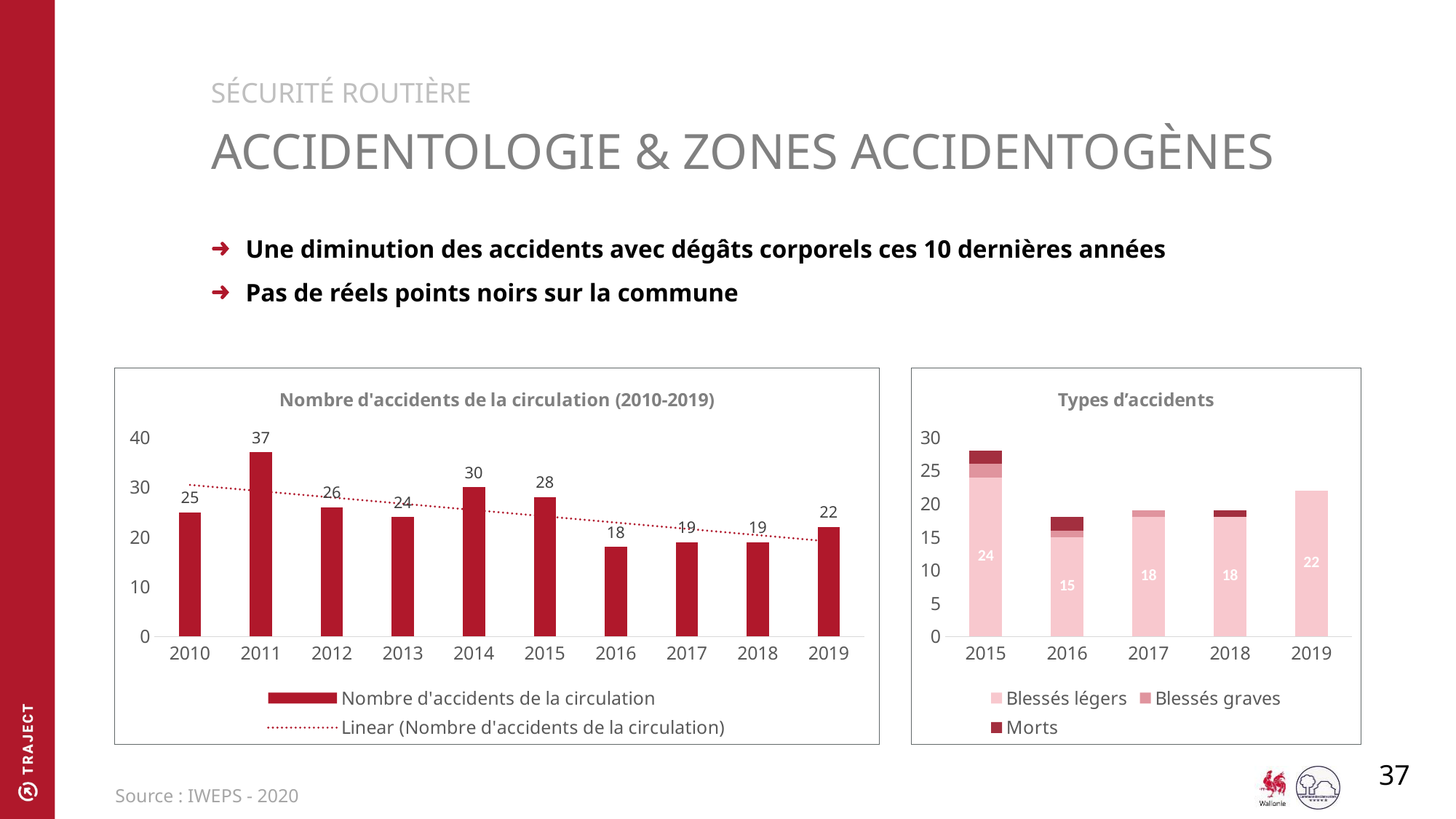
In the chart 'Nombre d'accidents de la circulation (2010-2019)', what is the value for 2016? 18 In the chart 'Nombre d'accidents de la circulation (2010-2019)', how many years are shown on the x axis? 10 In the chart 'Types d'accidents', what is the value for Blessés légers in 2016? 15 In the chart 'Nombre d'accidents de la circulation (2010-2019)', which is larger, the value for 2014 or the value for 2015? 2014 In the chart 'Types d'accidents', what is the value for Blessés légers in 2015? 24 In the chart 'Nombre d'accidents de la circulation (2010-2019)', which year has the lowest number of accidents? 2016 In the chart 'Types d'accidents', how many series does the legend list? 3 In the chart 'Nombre d'accidents de la circulation (2010-2019)', what is the value for 2011? 37 In the chart 'Nombre d'accidents de la circulation (2010-2019)', what is the difference between the values for 2011 and 2019? 15 In the chart 'Nombre d'accidents de la circulation (2010-2019)', does the dotted trend line rise or fall from 2010 to 2019? fall In the chart 'Nombre d'accidents de la circulation (2010-2019)', which year has the highest number of accidents? 2011 In the chart 'Types d'accidents', is the total for 2015 greater or less than 25? greater